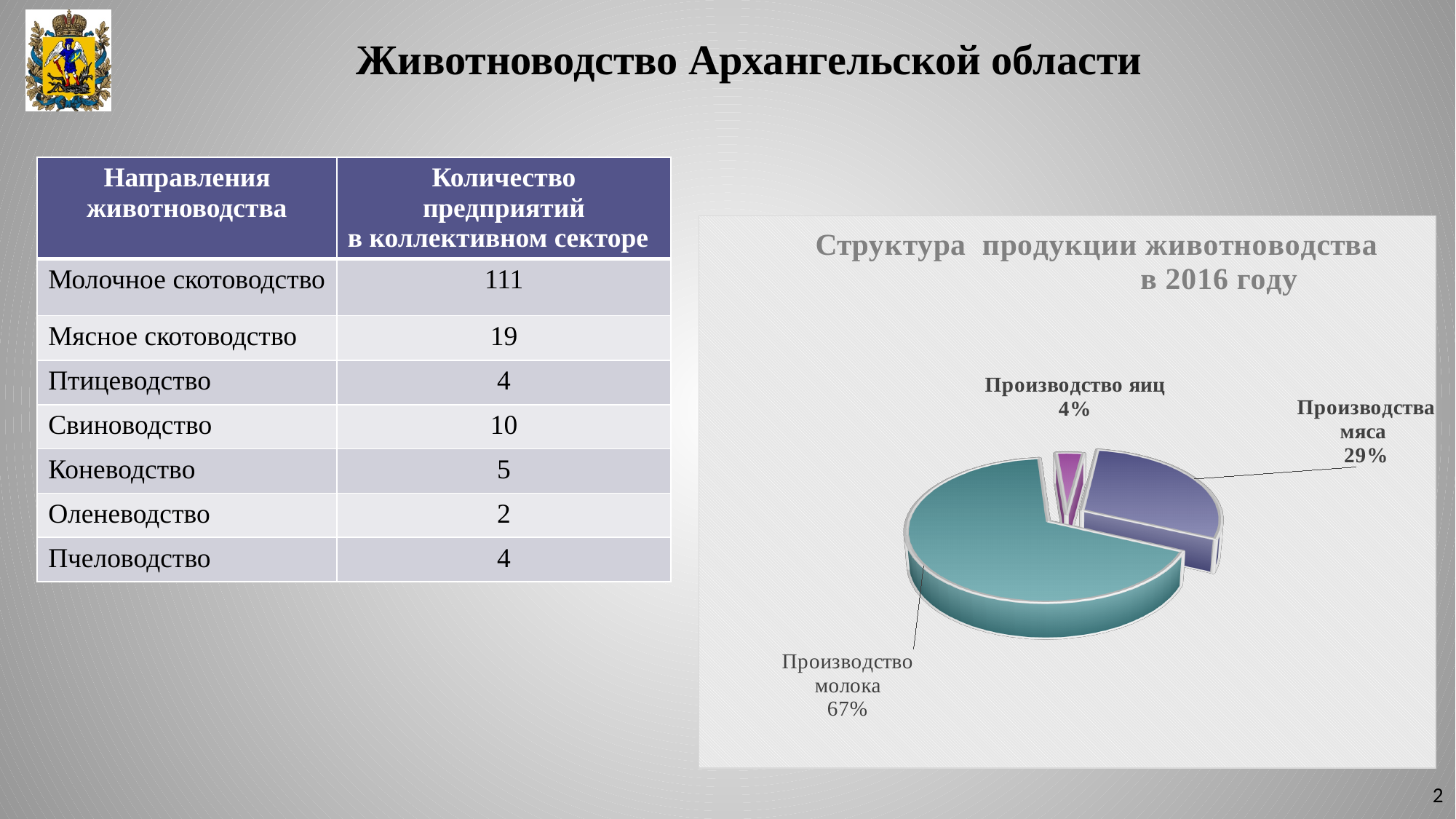
Which slice of the pie chart is the largest? Производство молока What share of the pie does Производство молока have? 67% How many slices does the pie chart have? 3 What is the title of the pie chart? Структура продукции животноводства в 2016 году What is the difference in percentage points between Производства мяса and Производство яиц? 25 What kind of chart is shown on the slide? Pie chart Which is larger, the share for Производства мяса or the share for Производство яиц? Производства мяса What share of the pie does Производство яиц have? 4% What share of the pie does Производства мяса have? 29% Which year does the pie chart's title refer to? 2016 What is the difference in percentage points between Производство молока and Производства мяса? 38 Which slice of the pie chart is the smallest? Производство яиц